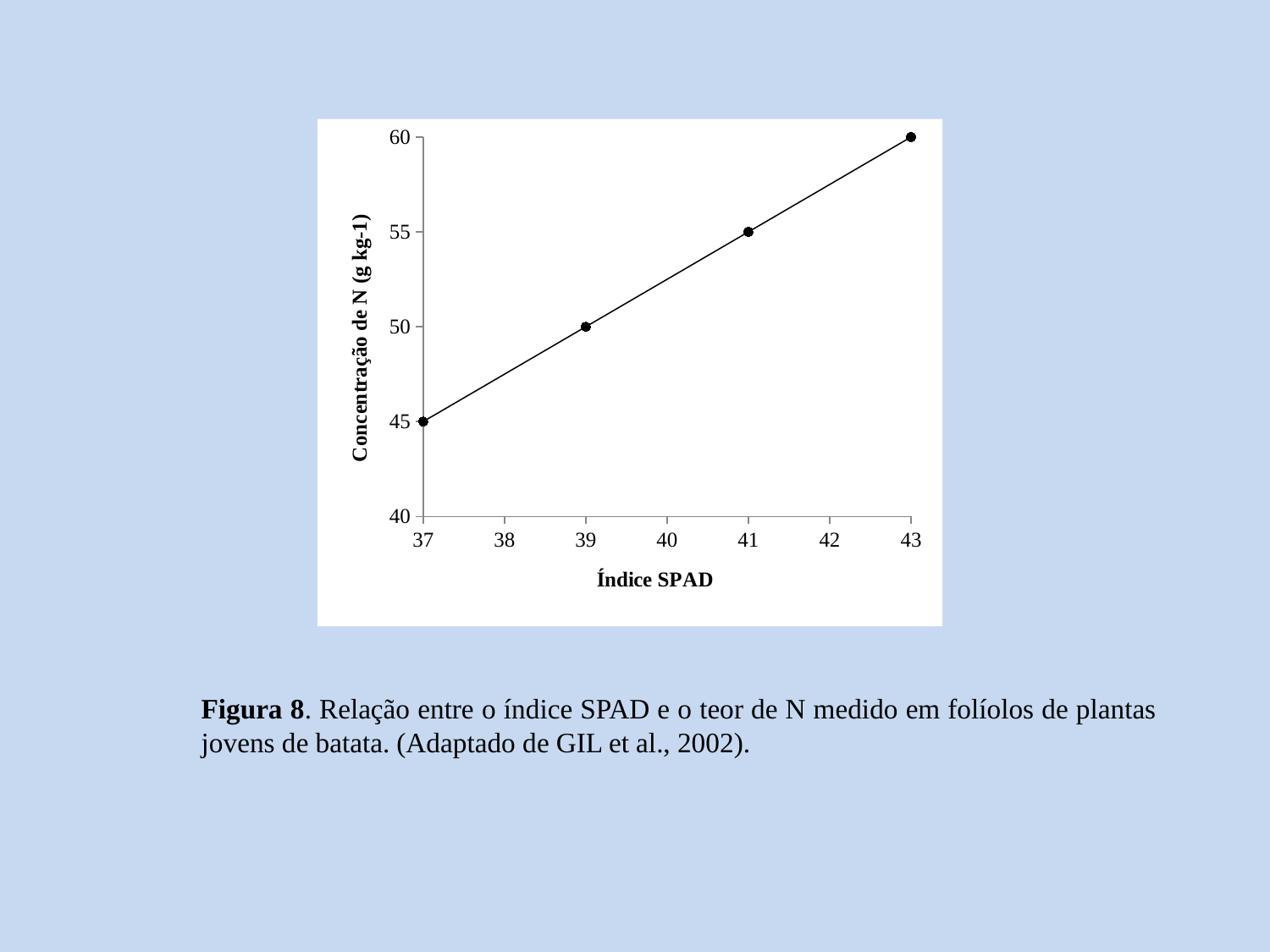
What kind of chart is shown on the slide? Line chart Does the N concentration rise or fall as the SPAD index increases? Rises What is the label of the x axis of the chart? Índice SPAD Which has a higher N concentration: SPAD index 39 or SPAD index 41? SPAD index 41 How many data points are plotted on the chart? 4 What is the difference in N concentration (g kg-1) between SPAD index 43 and SPAD index 37? 15 At which SPAD index is the N concentration highest? 43 What is the N concentration (g kg-1) at SPAD index 39? 50 What is the N concentration (g kg-1) at SPAD index 37? 45 What is the N concentration (g kg-1) at SPAD index 43? 60 What is the N concentration (g kg-1) at SPAD index 41? 55 At which SPAD index is the N concentration lowest? 37